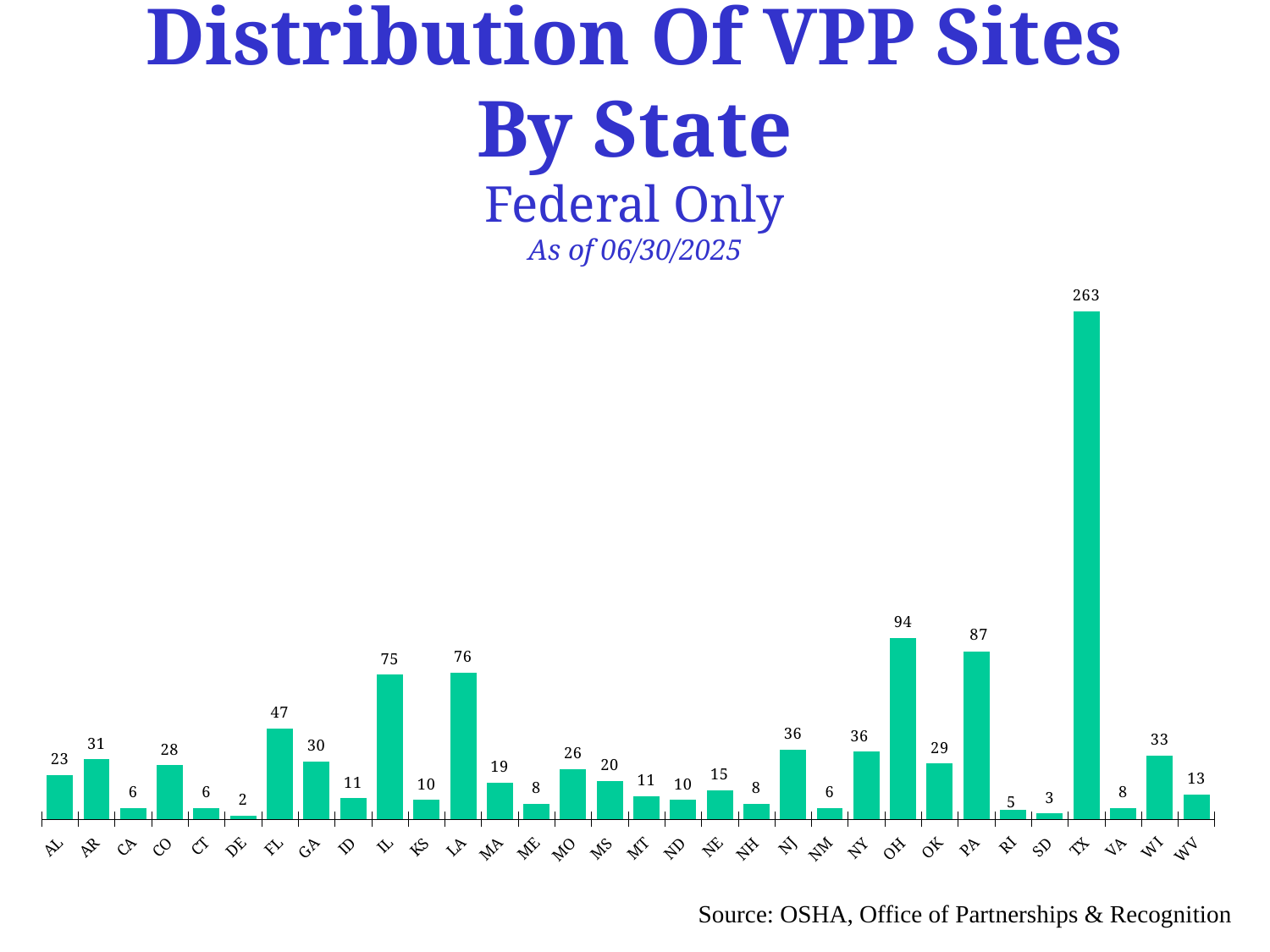
What date is the chart data reported as of? 06/30/2025 What is the difference between the values for OH and PA? 7 Which is larger, the value for FL or the value for GA? FL What is the value for OH? 94 Which state has the highest number of VPP sites? TX What kind of chart is shown on the slide? Bar chart What is the value for MA? 19 Which state has the lowest number of VPP sites? DE What is the value for TX? 263 What is the value for FL? 47 How many states are shown on the x axis? 32 What is the difference between the values for TX and OH? 169